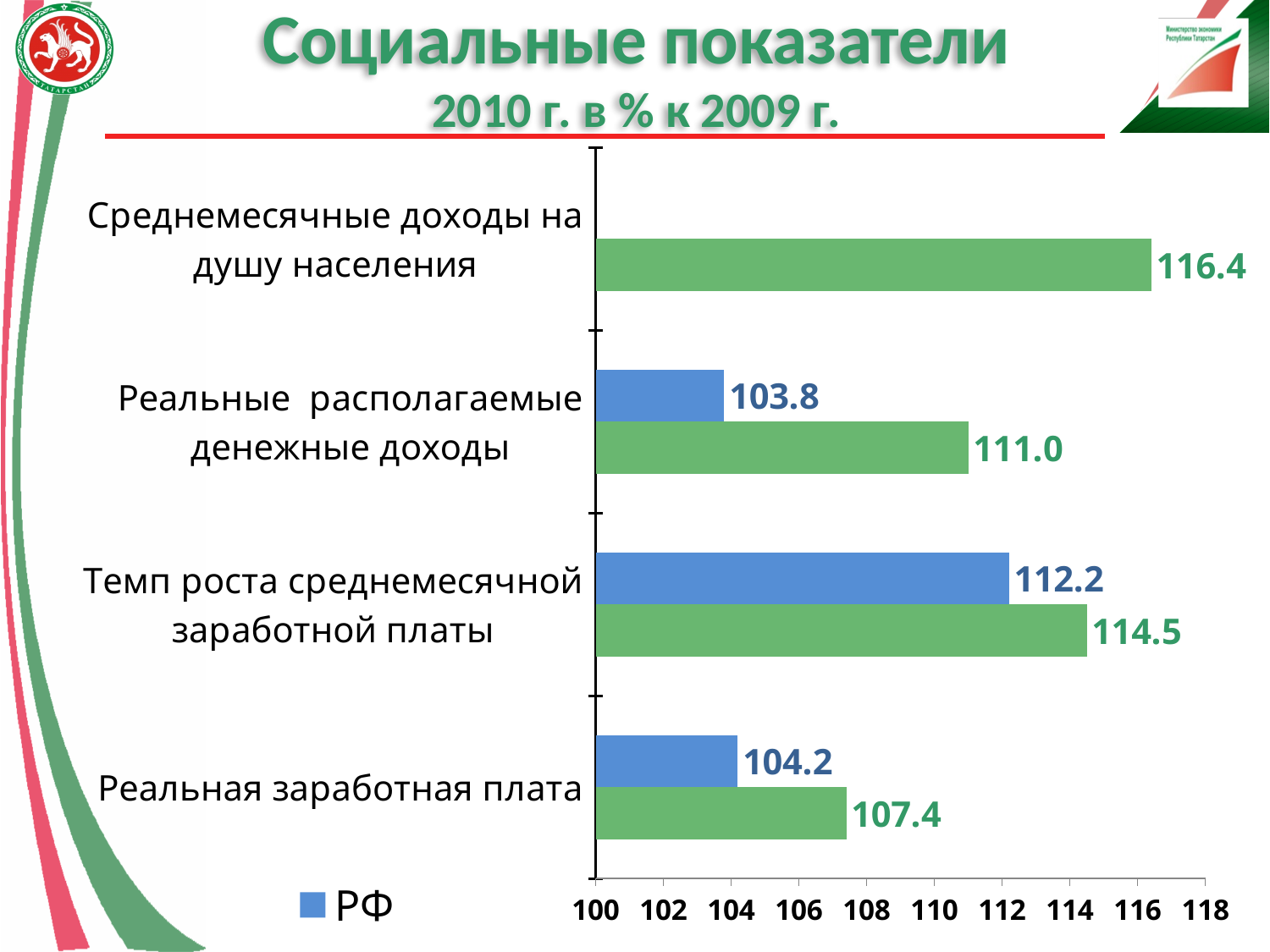
What is the value for РФ for Реальные располагаемые денежные доходы? 103.8 For Темп роста среднемесячной заработной платы, which is larger: the РФ value or the green bar value? the green bar value (114.5) Which category has the highest green bar value? Среднемесячные доходы на душу населения How many categories are shown on the chart? 4 What is the value for РФ for Реальная заработная плата? 104.2 What kind of chart is shown on the slide? bar chart What is the value of the green bar for Темп роста среднемесячной заработной платы? 114.5 What is the value of the green bar for Среднемесячные доходы на душу населения? 116.4 Which category has the lowest value for РФ? Реальные располагаемые денежные доходы What is the difference between the green bar and the РФ bar for Реальные располагаемые денежные доходы? 7.2 What series name is shown in the chart legend? РФ Is the green bar value for Реальная заработная плата greater or less than 108? less